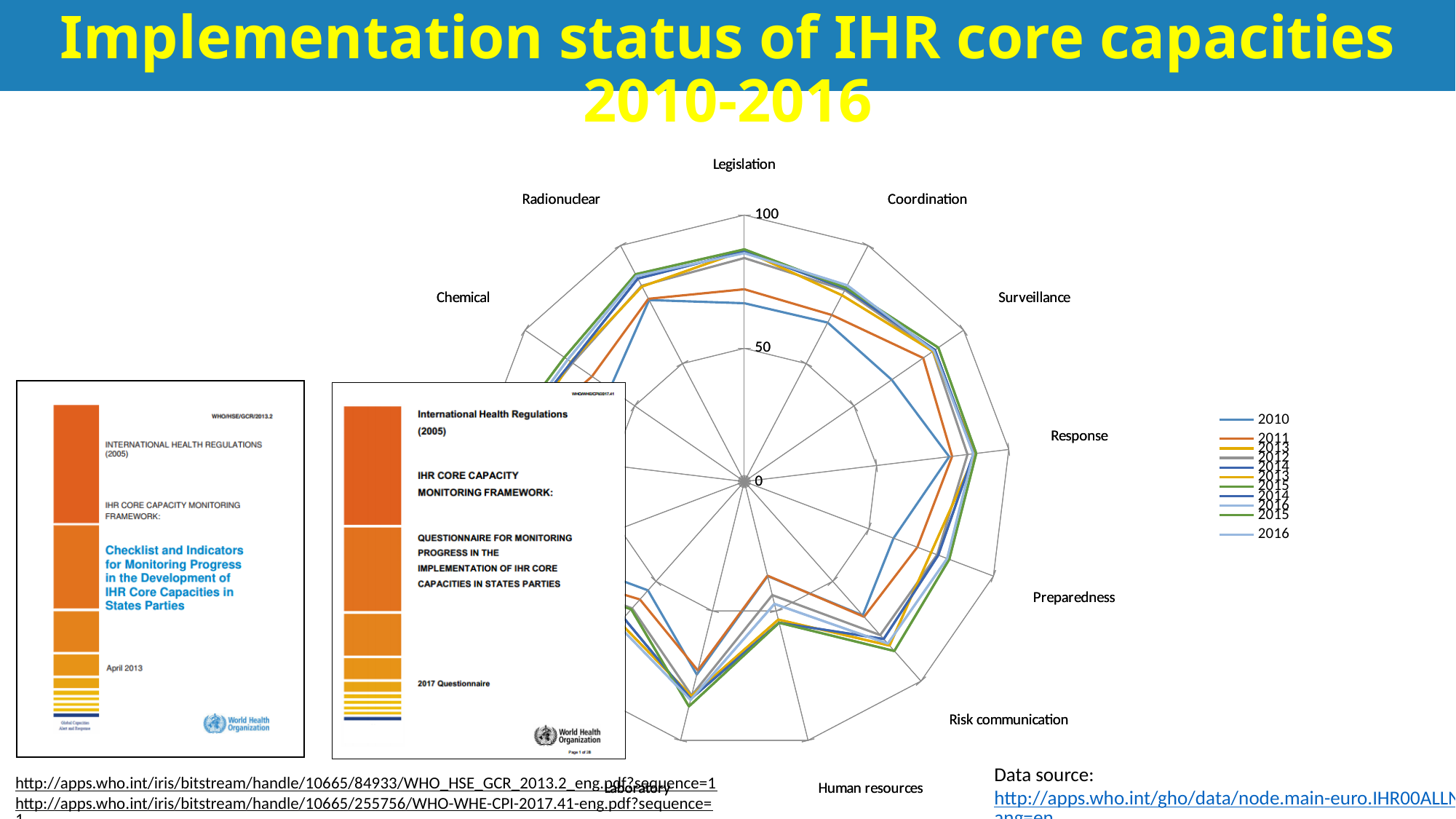
For Legislation, which year has the larger value, 2010 or 2016? 2016 For Human resources, which year has the larger value, 2011 or 2015? 2015 What is the title of the slide containing the chart? Implementation status of IHR core capacities 2010-2016 What kind of chart is shown on the slide? radar chart Is the 2016 value for Response greater or less than 50? greater Is the 2010 value for Legislation greater or less than 50? greater Is the 2010 value for Coordination greater or less than 50? greater How many distinct years (series) does the legend list? 7 What is the maximum value shown on the chart's axis scale? 100